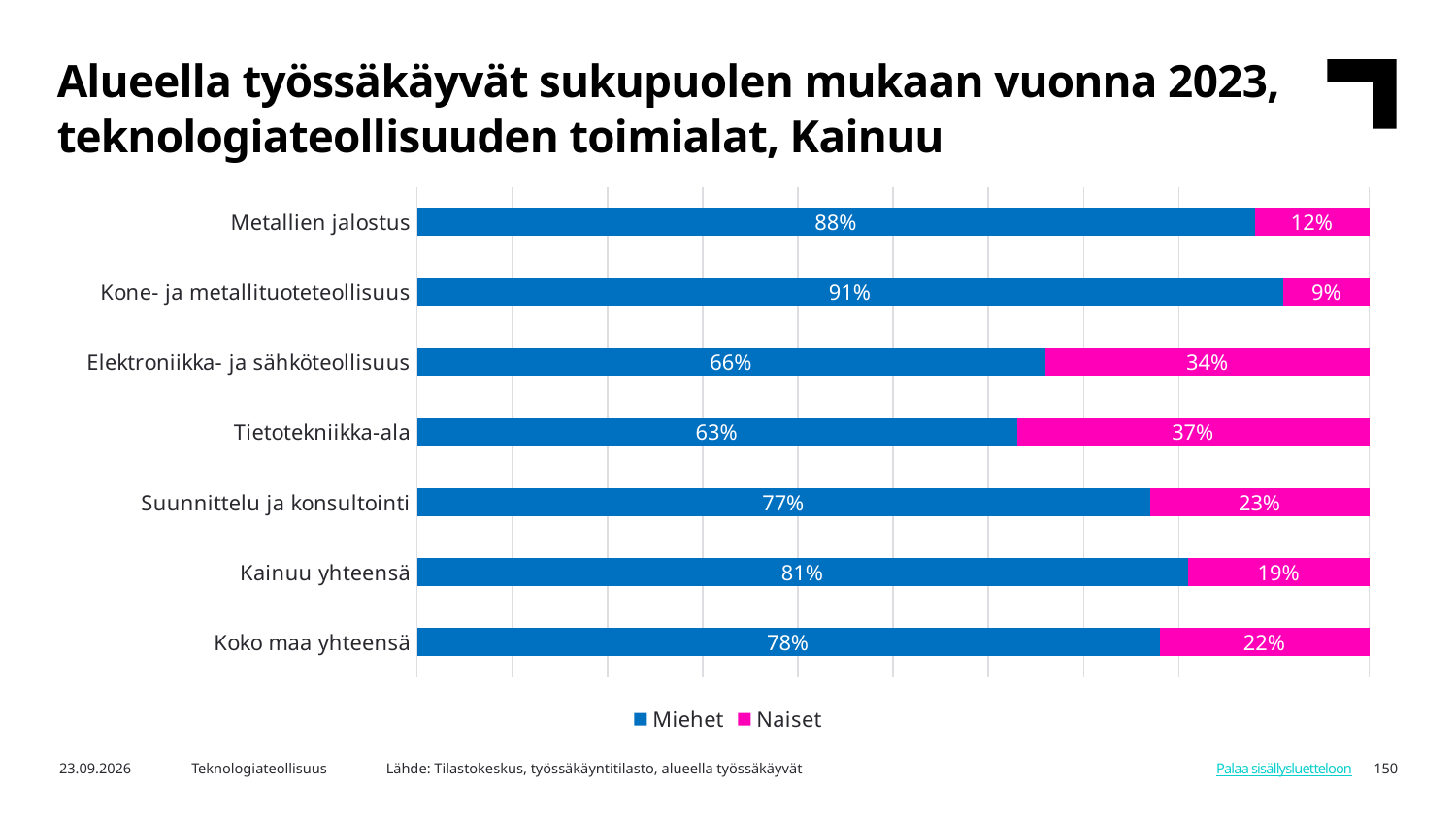
Which category has the lowest Naiset share? Kone- ja metallituoteteollisuus What is the difference between the Naiset share for Elektroniikka- ja sähköteollisuus and for Metallien jalostus? 22 percentage points What is the Naiset share for Kainuu yhteensä? 19% Which is larger: the Miehet share for Suunnittelu ja konsultointi or for Kainuu yhteensä? Kainuu yhteensä How many series does the legend list? 2 How many categories are shown on the chart? 7 Which category has the highest Naiset share? Tietotekniikka-ala Which category has the highest Miehet share? Kone- ja metallituoteteollisuus What kind of chart is shown on the slide? Stacked bar chart What is the Miehet share for Koko maa yhteensä? 78% What is the Naiset share for Tietotekniikka-ala? 37% What is the Miehet share for Metallien jalostus? 88%